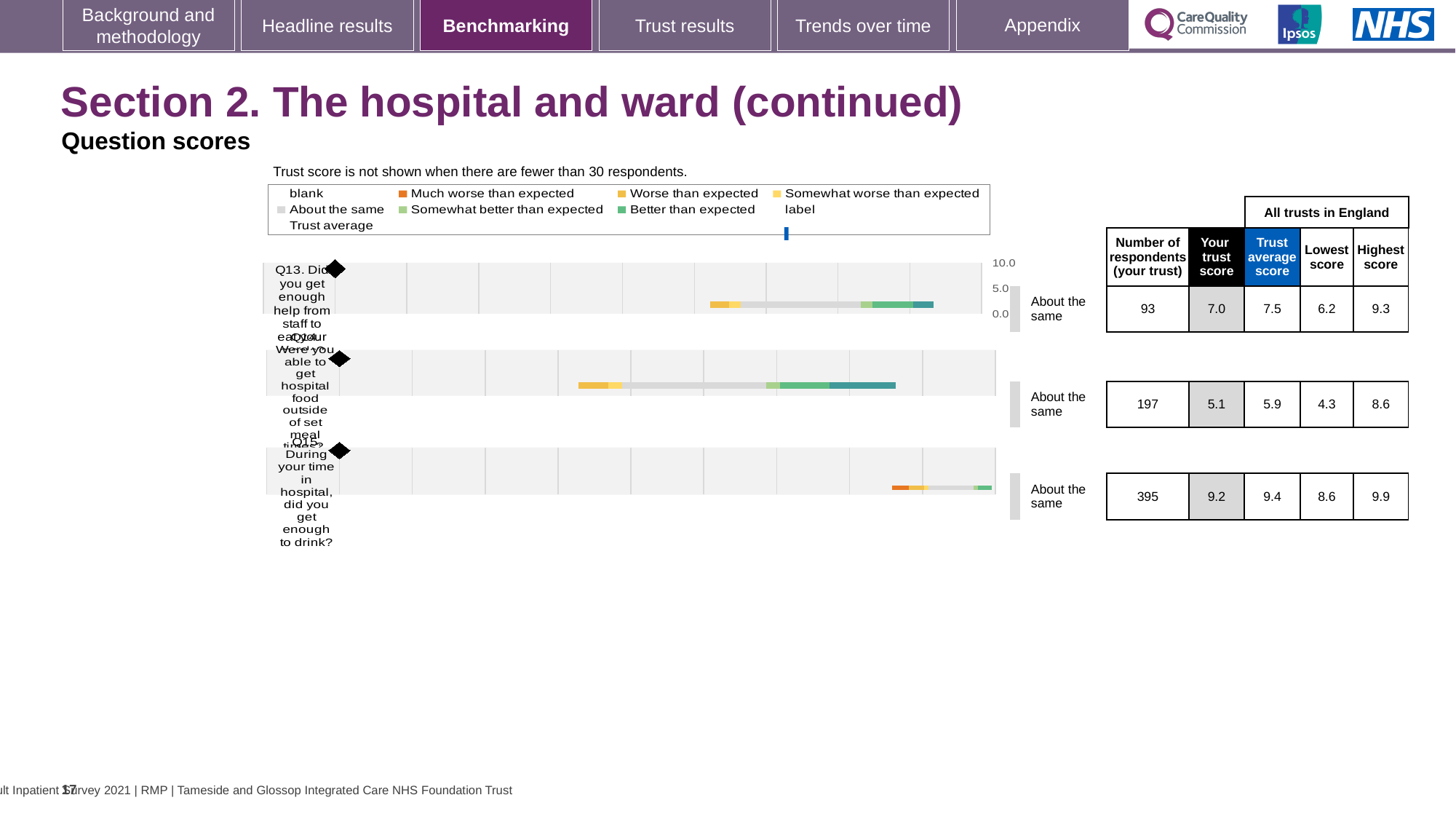
What kind of chart is used to show the question scores on this slide? Bar chart Which question has the lowest 'Your trust score'? Q14 For Q13, which is larger: the 'Your trust score' or the trust average score? Trust average score What is the lowest score across all trusts in England for Q14? 4.3 What benchmark category is shown next to the Q14 bar? About the same What is the 'Your trust score' value for Q13 (Did you get enough help from staff to eat your meals?)? 7.0 Which question has the highest 'Your trust score'? Q15 How many questions (rows) are plotted in the benchmarking chart on this slide? 3 How many respondents are shown for Q15 (During your time in hospital, did you get enough to drink?)? 395 According to the note above the chart, the trust score is not shown when there are fewer than how many respondents? 30 What is the trust average score for Q14 (Were you able to get hospital food outside of set meal times?)? 5.9 For Q15, what is the difference between the highest score and the lowest score across all trusts in England? 1.3